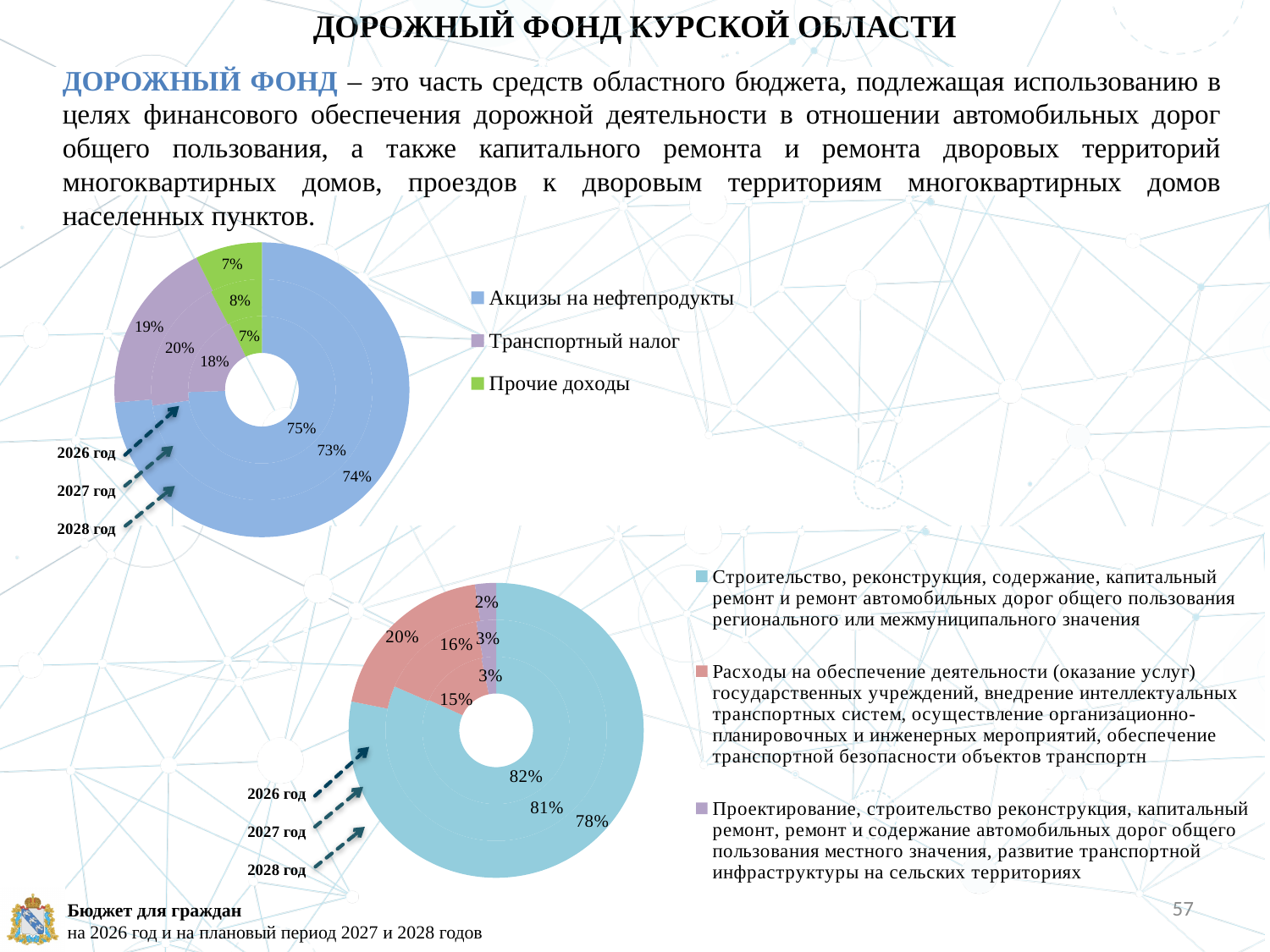
In the top chart, what share do Акцизы на нефтепродукты have in the innermost ring (2026 год)? 75% In the top chart, what is the difference between the Акцизы на нефтепродукты share and the Транспортный налог share in the innermost ring (2026 год)? 57 percentage points In the bottom chart, what share does the Расходы на обеспечение деятельности category have in the innermost ring (2026 год)? 15% What colour represents Прочие доходы in the top chart? Green In the top chart, what share do Прочие доходы have in the outermost ring (2028 год)? 7% In the bottom chart, what share does the largest category (Строительство, реконструкция, содержание, капитальный ремонт...) have in the outermost ring (2028 год)? 78% What type of chart is the top chart on the slide? Doughnut (pie) chart In the bottom chart, which category has the smallest share in every ring? Проектирование, строительство реконструкция, капитальный ремонт, ремонт и содержание автомобильных дорог общего пользования местного значения In the top chart, which category has the largest share in every ring? Акцизы на нефтепродукты How many entries does the legend of the top chart list? 3 How many entries does the legend of the bottom chart list? 3 In the top chart, what share does Транспортный налог have in the middle ring (2027 год)? 20%